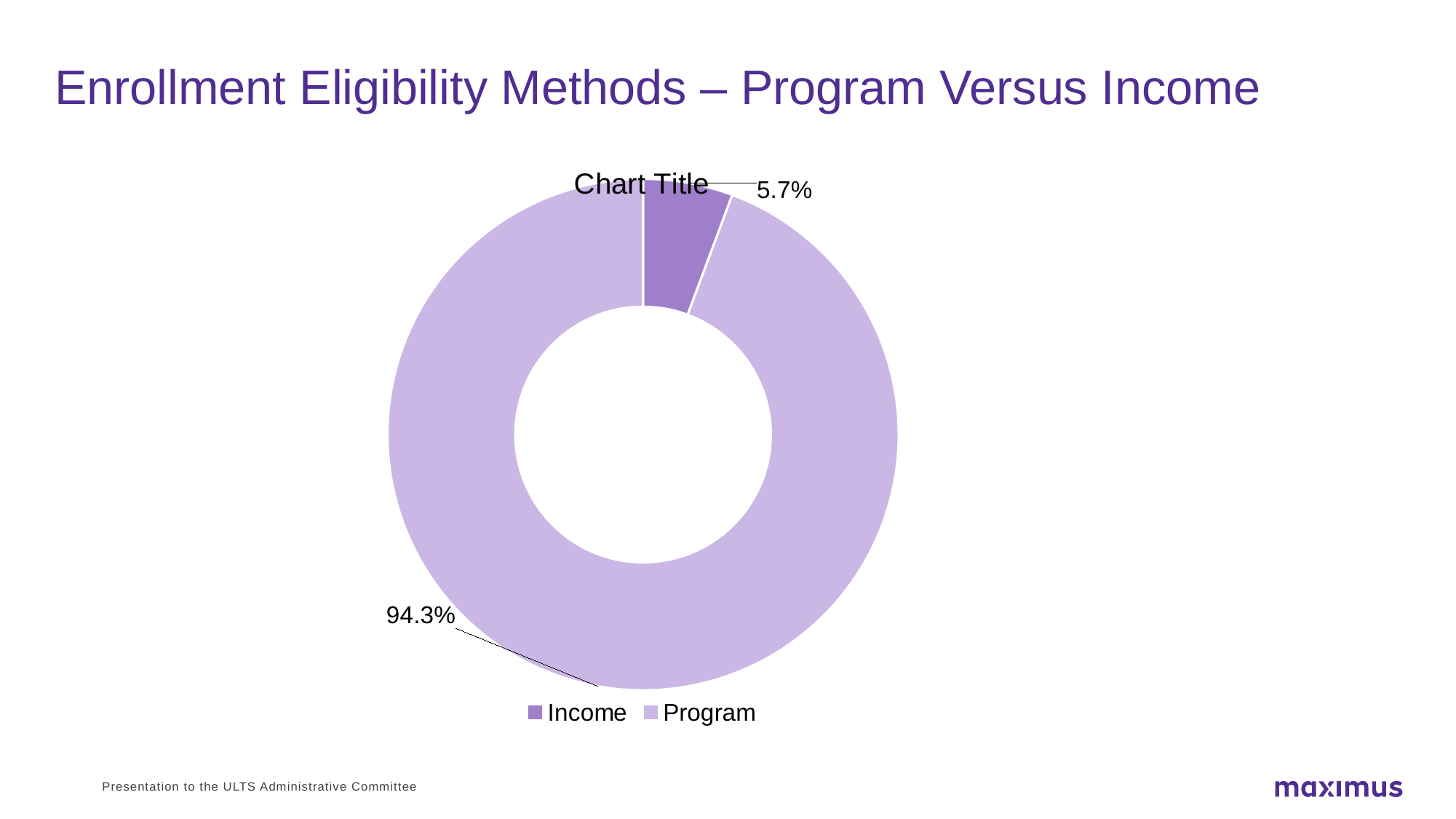
Which legend entry is shown in the darker purple colour? Income What percentage of the doughnut chart is labelled for Income? 5.7% Which category has the smallest share of the doughnut chart? Income What kind of chart is shown on the slide? Doughnut chart Which is larger, the share for Income or the share for Program? Program What percentage of the doughnut chart is labelled for Program? 94.3% How many entries does the legend list? 2 How many categories does the doughnut chart show? 2 What is the title printed above the chart? Chart Title What is the difference in percentage points between the Program share and the Income share? 88.6 Which category has the largest share of the doughnut chart? Program